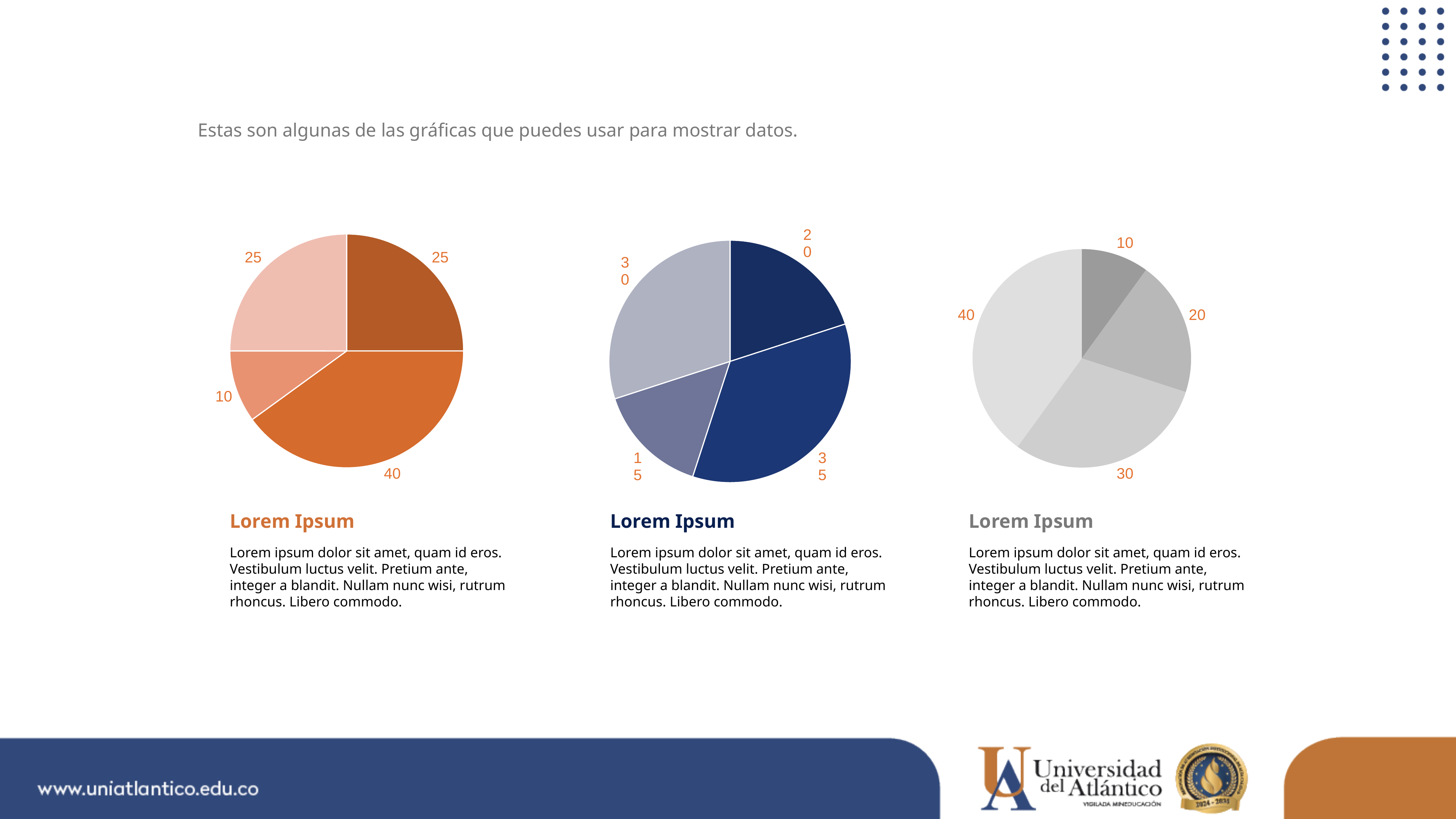
How many slices does the right-hand pie chart have? 4 In the middle pie chart, what is the value of the smallest slice? 15 How many slices does the left-hand pie chart have? 4 What kind of chart is the left-hand chart on the slide? pie chart In the right-hand pie chart, what is the difference between the largest slice (40) and the smallest slice (10)? 30 In the right-hand pie chart, what is the value of the largest slice? 40 In the middle pie chart, what is the value of the largest slice? 35 In the left-hand pie chart, what colour is the slice labelled 40? orange In the middle pie chart, what share of the whole pie does the slice labelled 35 represent? 35% In the left-hand pie chart, what is the value of the smallest slice? 10 In the left-hand pie chart, what is the value of the largest slice? 40 How many slices does the middle pie chart have? 4